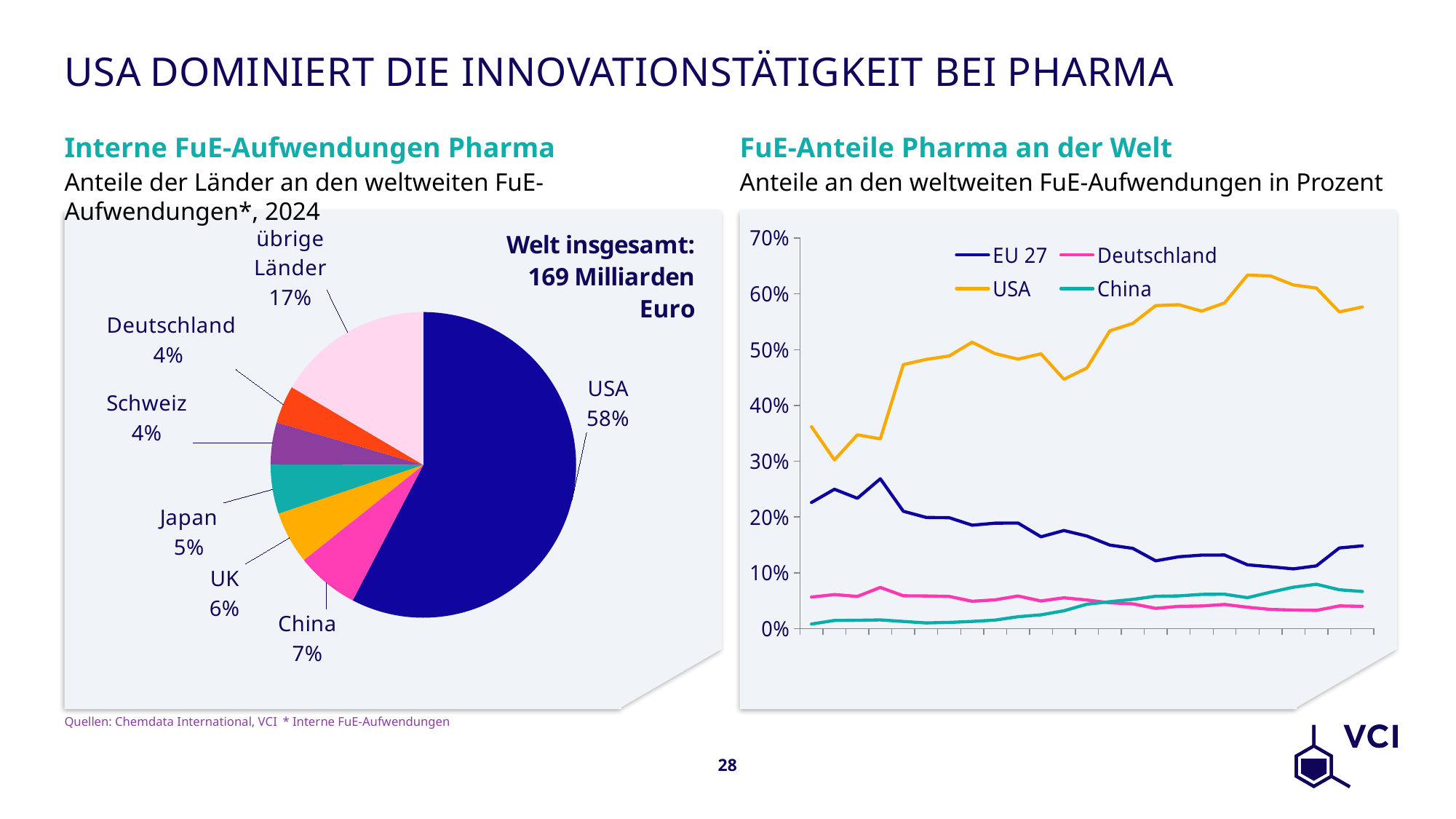
In the pie chart 'Interne FuE-Aufwendungen Pharma', what share does the USA have? 58% How many series does the legend of the chart 'FuE-Anteile Pharma an der Welt' list? 4 How many slices does the pie chart 'Interne FuE-Aufwendungen Pharma' have? 7 In the chart 'FuE-Anteile Pharma an der Welt', does the EU 27 line rise or fall along the x axis overall? Fall In the pie chart 'Interne FuE-Aufwendungen Pharma', what is the difference between the shares of the USA and übrige Länder? 41 percentage points In the chart 'FuE-Anteile Pharma an der Welt', is the final value of the USA line greater or less than 50%? greater In the pie chart 'Interne FuE-Aufwendungen Pharma', which country has the largest share? USA In the pie chart 'Interne FuE-Aufwendungen Pharma', which has the larger share, UK or Japan? UK In the pie chart 'Interne FuE-Aufwendungen Pharma', what share does China have? 7% What kind of chart is 'FuE-Anteile Pharma an der Welt'? Line chart What is the world total stated on the pie chart 'Interne FuE-Aufwendungen Pharma'? 169 Milliarden Euro In the chart 'FuE-Anteile Pharma an der Welt', is the final value of the China line greater or less than 10%? less